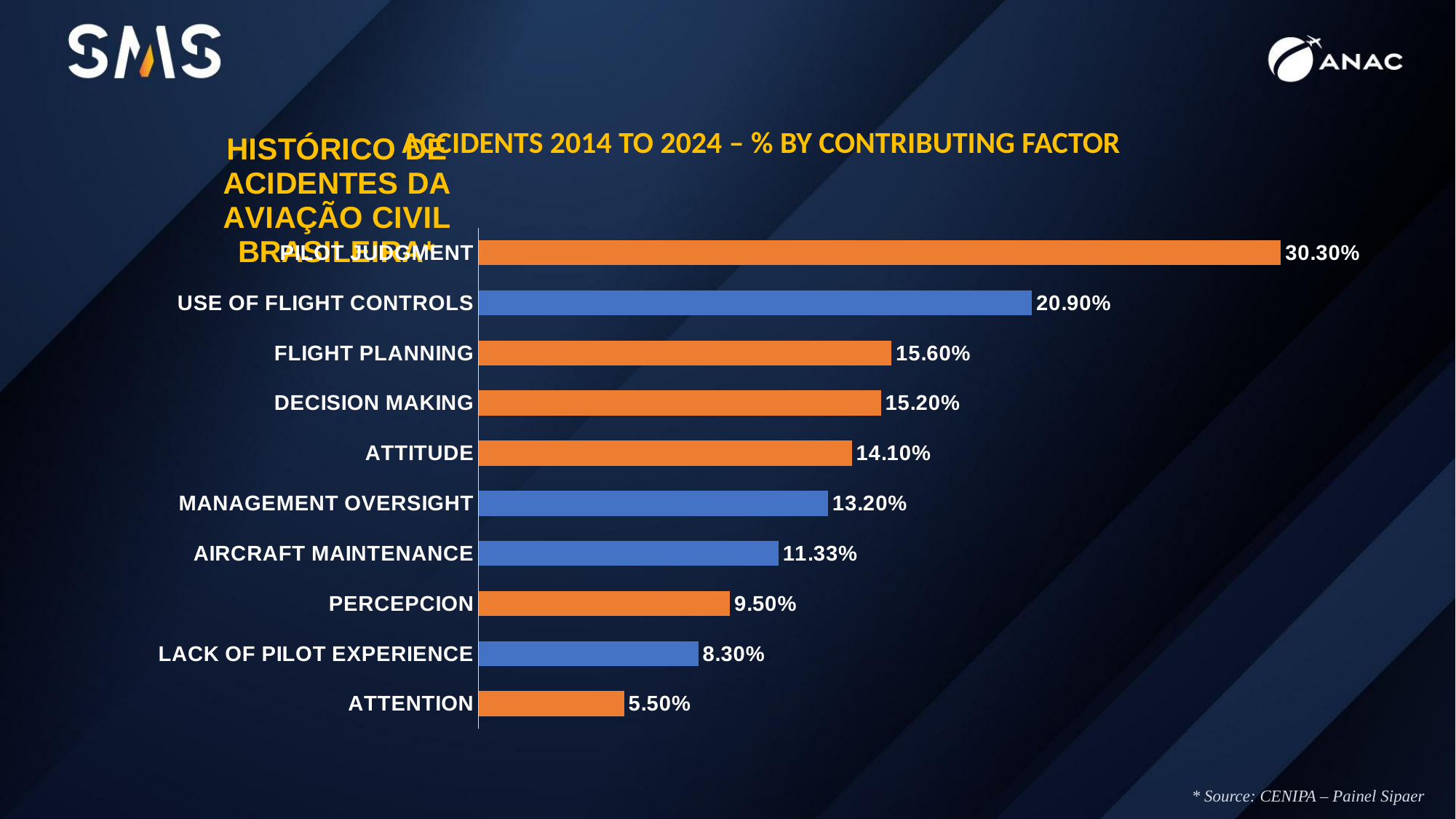
What is the value for AIRCRAFT MAINTENANCE? 11.33% Which category has the lowest value? ATTENTION What is the highest value shown in the chart? 30.30% What is the difference between FLIGHT PLANNING and DECISION MAKING? 0.40% How many categories are shown in the chart? 10 What is the title of the chart? ACCIDENTS 2014 TO 2024 – % BY CONTRIBUTING FACTOR Which is larger, PERCEPCION or LACK OF PILOT EXPERIENCE? PERCEPCION What kind of chart is shown on the slide? bar chart What is the value for MANAGEMENT OVERSIGHT? 13.20% What is the value for USE OF FLIGHT CONTROLS? 20.90% What is the value for ATTENTION? 5.50% What is the difference between USE OF FLIGHT CONTROLS and ATTITUDE? 6.80%